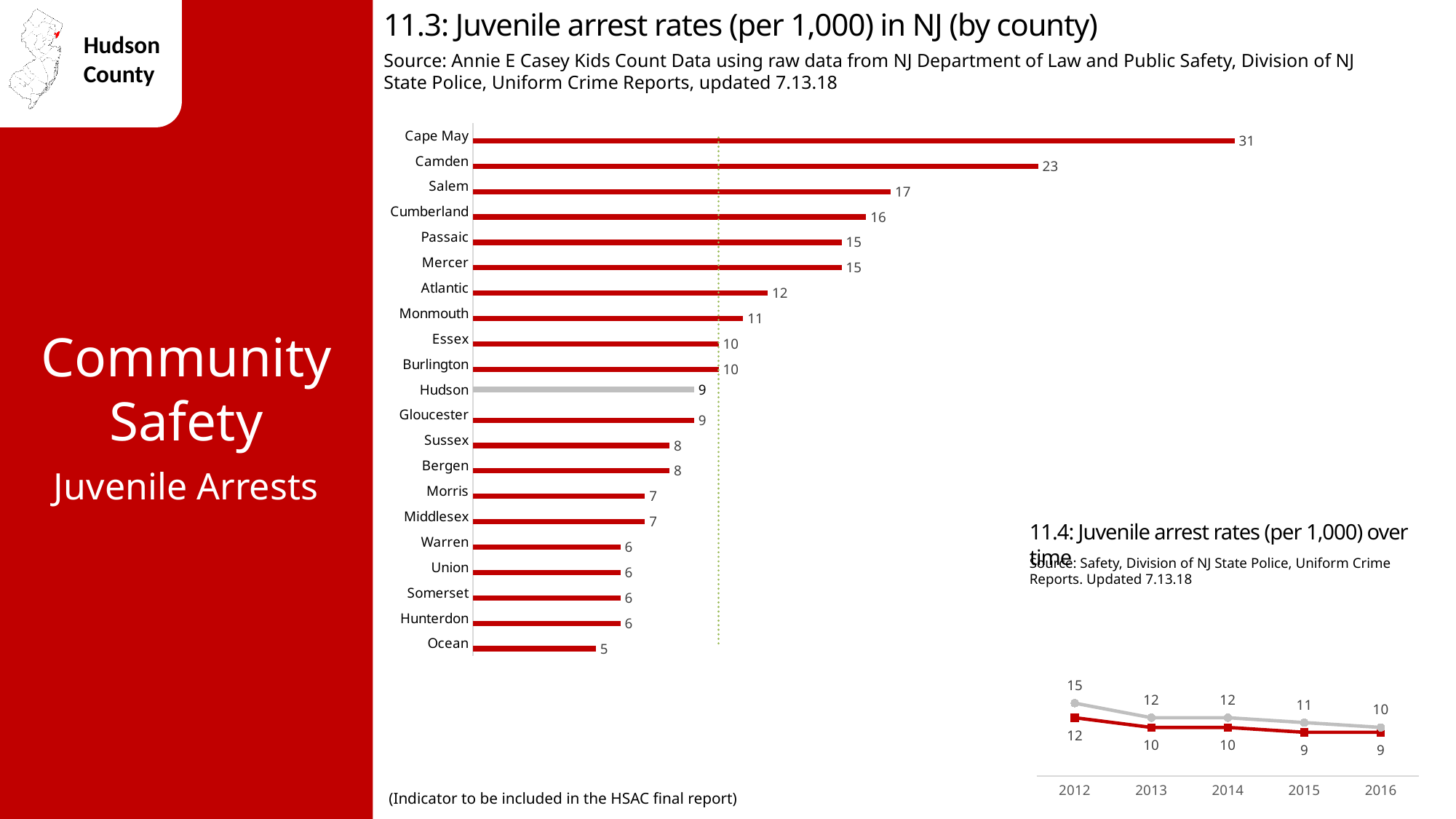
In the chart '11.4: Juvenile arrest rates (per 1,000) over time', what is the value of the red line in 2016? 9 In the chart '11.4: Juvenile arrest rates (per 1,000) over time', what is the value of the gray line in 2012? 15 In the chart '11.3: Juvenile arrest rates (per 1,000) in NJ (by county)', what is the value for Hudson? 9 In the chart '11.3: Juvenile arrest rates (per 1,000) in NJ (by county)', what is the value for Camden? 23 In the chart '11.3: Juvenile arrest rates (per 1,000) in NJ (by county)', what is the difference between the values for Cape May and Hudson? 22 In the chart '11.3: Juvenile arrest rates (per 1,000) in NJ (by county)', which county's bar is coloured gray instead of red? Hudson How many counties are shown in the chart '11.3: Juvenile arrest rates (per 1,000) in NJ (by county)'? 21 In the chart '11.4: Juvenile arrest rates (per 1,000) over time', do the values rise or fall from 2012 to 2016? Fall In the chart '11.3: Juvenile arrest rates (per 1,000) in NJ (by county)', which has a higher value, Salem or Atlantic? Salem What kind of chart is '11.3: Juvenile arrest rates (per 1,000) in NJ (by county)'? Bar chart In the chart '11.3: Juvenile arrest rates (per 1,000) in NJ (by county)', which county has the lowest juvenile arrest rate? Ocean In the chart '11.3: Juvenile arrest rates (per 1,000) in NJ (by county)', which county has the highest juvenile arrest rate? Cape May